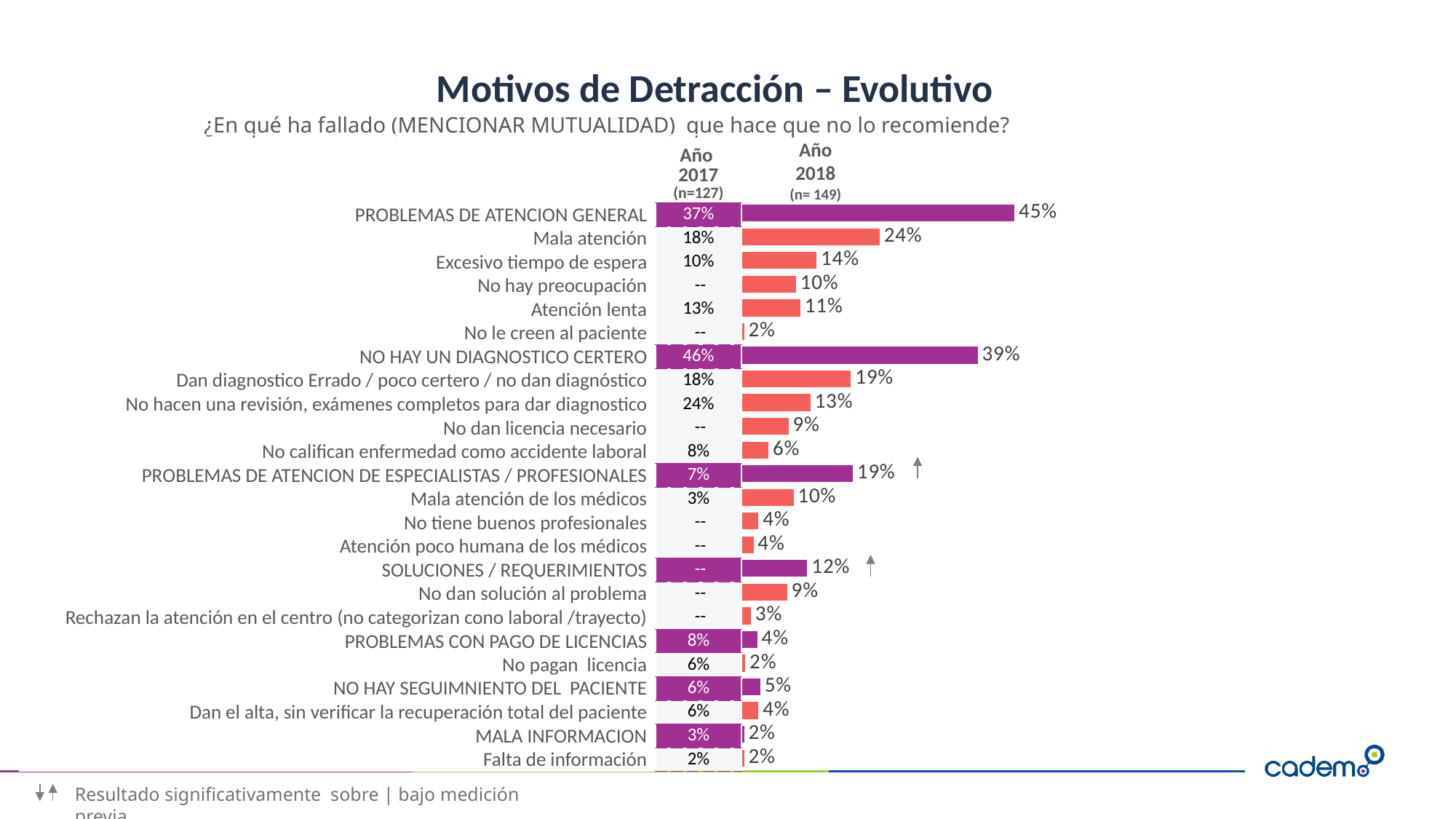
Which is larger for Excesivo tiempo de espera: the Año 2017 value or the Año 2018 value? Año 2018 What is the Año 2017 value for NO HAY UN DIAGNOSTICO CERTERO? 46% What kind of chart is shown on the slide? Bar chart What is the Año 2018 value for Mala atención? 24% How many categories are listed in the chart? 24 Which category has the highest Año 2018 value? PROBLEMAS DE ATENCION GENERAL What is the Año 2018 value for SOLUCIONES / REQUERIMIENTOS? 12% Which is larger for No hacen una revisión, exámenes completos para dar diagnostico: the Año 2017 value or the Año 2018 value? Año 2017 What is the difference between the Año 2018 and Año 2017 values for PROBLEMAS DE ATENCION DE ESPECIALISTAS / PROFESIONALES? 12% What is the Año 2018 value for PROBLEMAS DE ATENCION GENERAL? 45% What is the difference between the Año 2018 values for PROBLEMAS DE ATENCION GENERAL and NO HAY UN DIAGNOSTICO CERTERO? 6% What is the sample size (n) shown for Año 2018? n= 149